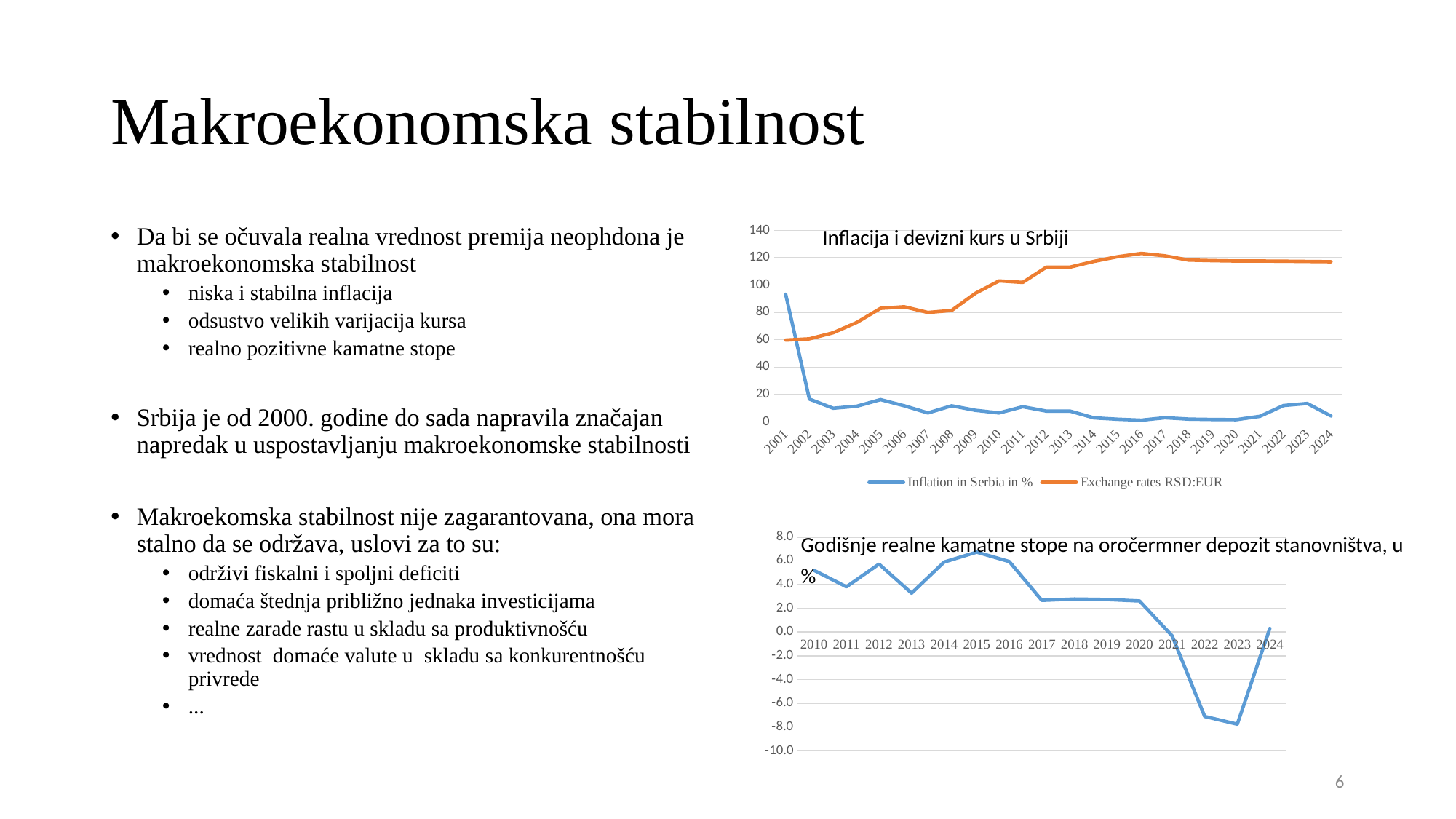
In the 'Inflacija i devizni kurs u Srbiji' chart, how many years are shown on the x axis? 24 In the 'Inflacija i devizni kurs u Srbiji' chart, which year has the highest value for Inflation in Serbia in %? 2001 In the bottom chart (Godišnje realne kamatne stope), which year has the lowest value? 2023 What kind of chart is the 'Inflacija i devizni kurs u Srbiji' chart? line chart In the bottom chart (Godišnje realne kamatne stope), how many years are shown on the x axis? 15 In the 'Inflacija i devizni kurs u Srbiji' chart, is the value for Inflation in Serbia in % in 2001 greater or less than 80? greater How many series does the legend of the 'Inflacija i devizni kurs u Srbiji' chart list? 2 In the 'Inflacija i devizni kurs u Srbiji' chart, is the value for Exchange rates RSD:EUR in 2012 greater or less than 100? greater In the bottom chart (Godišnje realne kamatne stope), is the value for 2022 greater or less than -6.0? less In the 'Inflacija i devizni kurs u Srbiji' chart, does the Exchange rates RSD:EUR series rise or fall from 2001 to 2016? rise In the 'Inflacija i devizni kurs u Srbiji' chart, which series has the larger value in 2024, Inflation in Serbia in % or Exchange rates RSD:EUR? Exchange rates RSD:EUR In the bottom chart (Godišnje realne kamatne stope), which year has the highest value? 2015